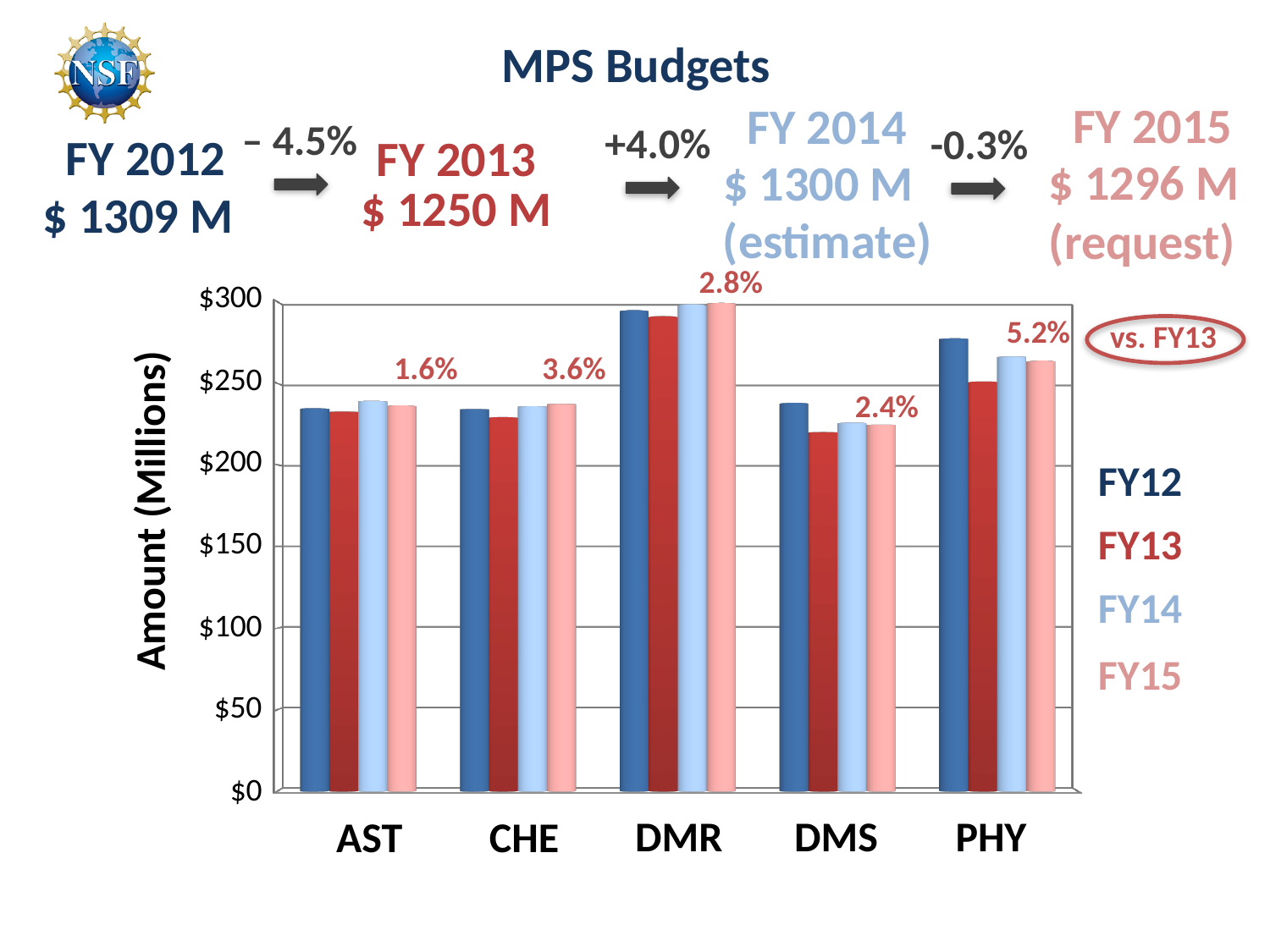
Is the FY12 value for PHY greater or less than $250? greater Which category has the highest FY14 value? DMR What percentage change vs. FY13 is labelled above the DMR bars? 2.8% How many categories are shown on the x axis of the chart? 5 What is the title of the chart's vertical axis? Amount (Millions) How many series does the chart's legend list? 4 Which category has the lowest FY15 value? DMS Which is larger, the FY12 value for PHY or the FY12 value for DMS? PHY Is the FY15 value for DMR greater or less than $250? greater What kind of chart is shown on the slide? bar chart Is the FY13 value for DMS greater or less than $250? less What percentage change vs. FY13 is labelled above the PHY bars? 5.2%